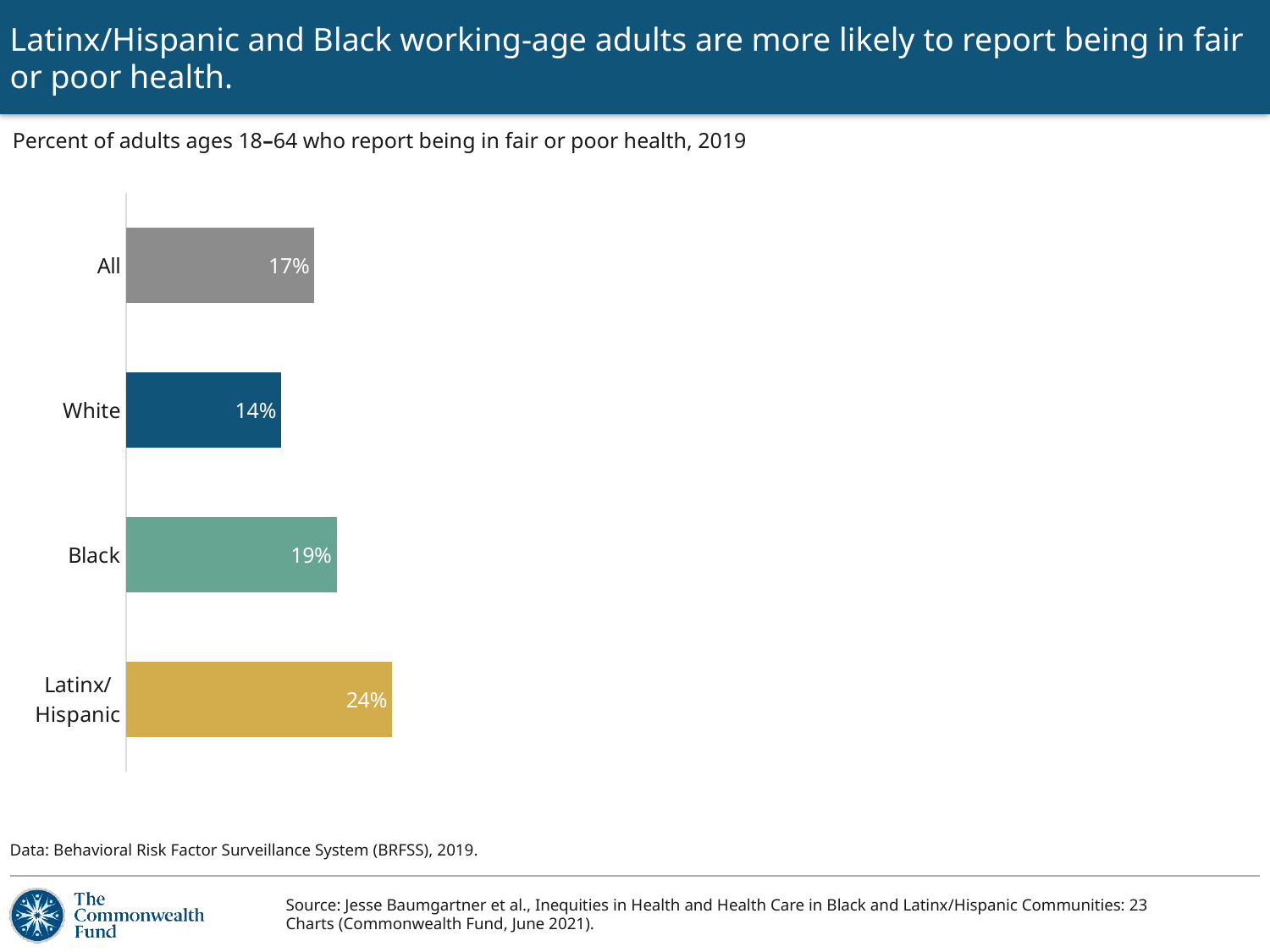
What is the value shown for Black adults? 19% What colour is the bar for Latinx/Hispanic adults? Gold/yellow What is the difference in percentage points between Black and All adults? 2 percentage points How many groups are shown in the chart? 4 Which is larger, the value for Black adults or the value for White adults? Black What is the difference in percentage points between Latinx/Hispanic and White adults? 10 percentage points What kind of chart is shown on the slide? Bar chart Which group has the highest percent reporting fair or poor health? Latinx/Hispanic Which group has the lowest percent reporting fair or poor health? White What is the value shown for White adults? 14% What percent of all adults ages 18–64 report being in fair or poor health? 17% What is the value shown for Latinx/Hispanic adults? 24%